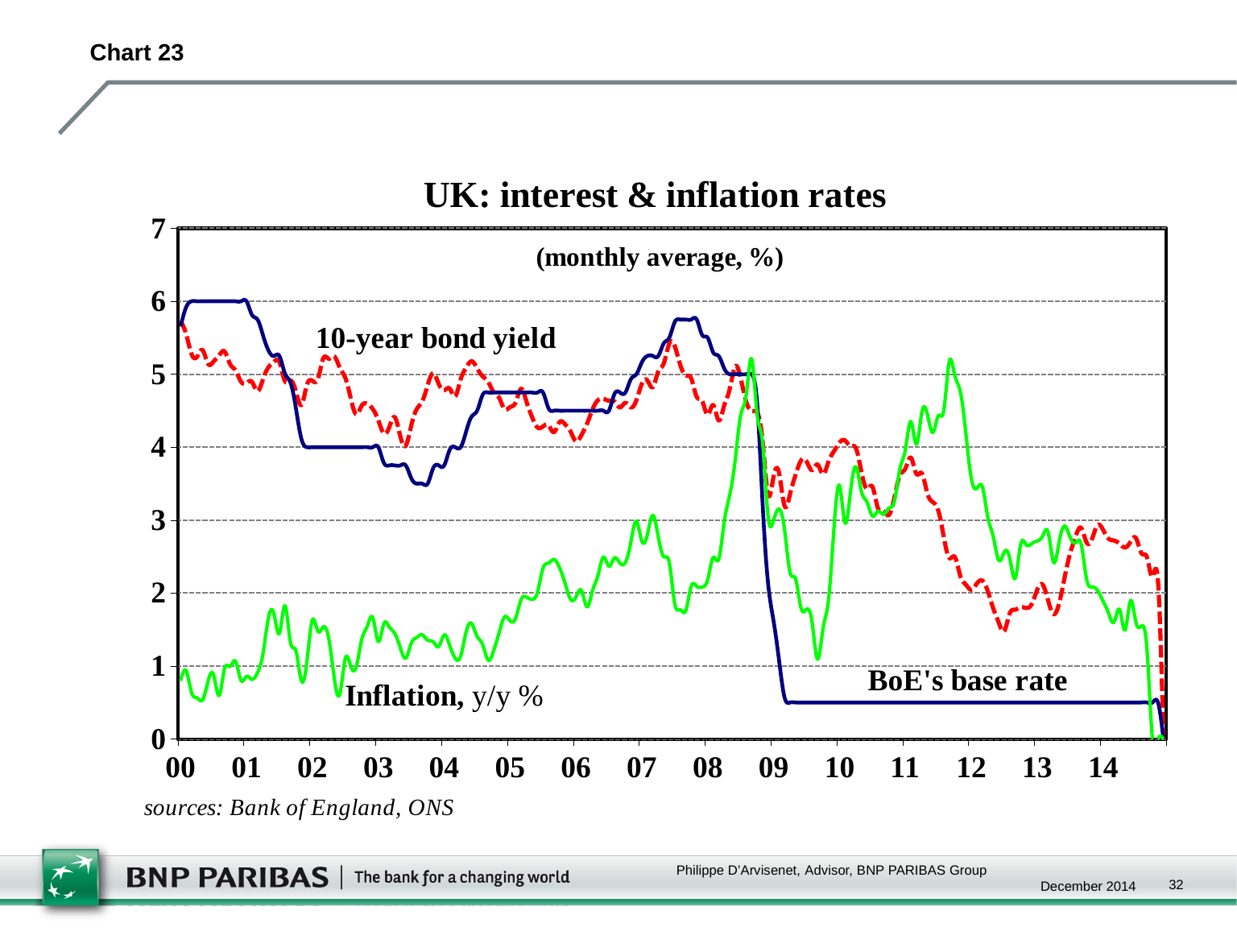
Is the 10-year bond yield at the start of 2000 greater or less than 4? greater What sources are cited below the chart? Bank of England, ONS Is inflation at the start of 2000 greater or less than 2? less In 2012, which is higher: the BoE's base rate or the 10-year bond yield? 10-year bond yield Is the BoE's base rate at the start of 2000 greater or less than 5? greater What is the title of the chart? UK: interest & inflation rates What kind of chart is shown on the slide? line chart In 2000, which is higher: inflation or the 10-year bond yield? 10-year bond yield How many series are plotted on the chart? 3 Does the BoE's base rate rise or fall between 2008 and 2009? fall